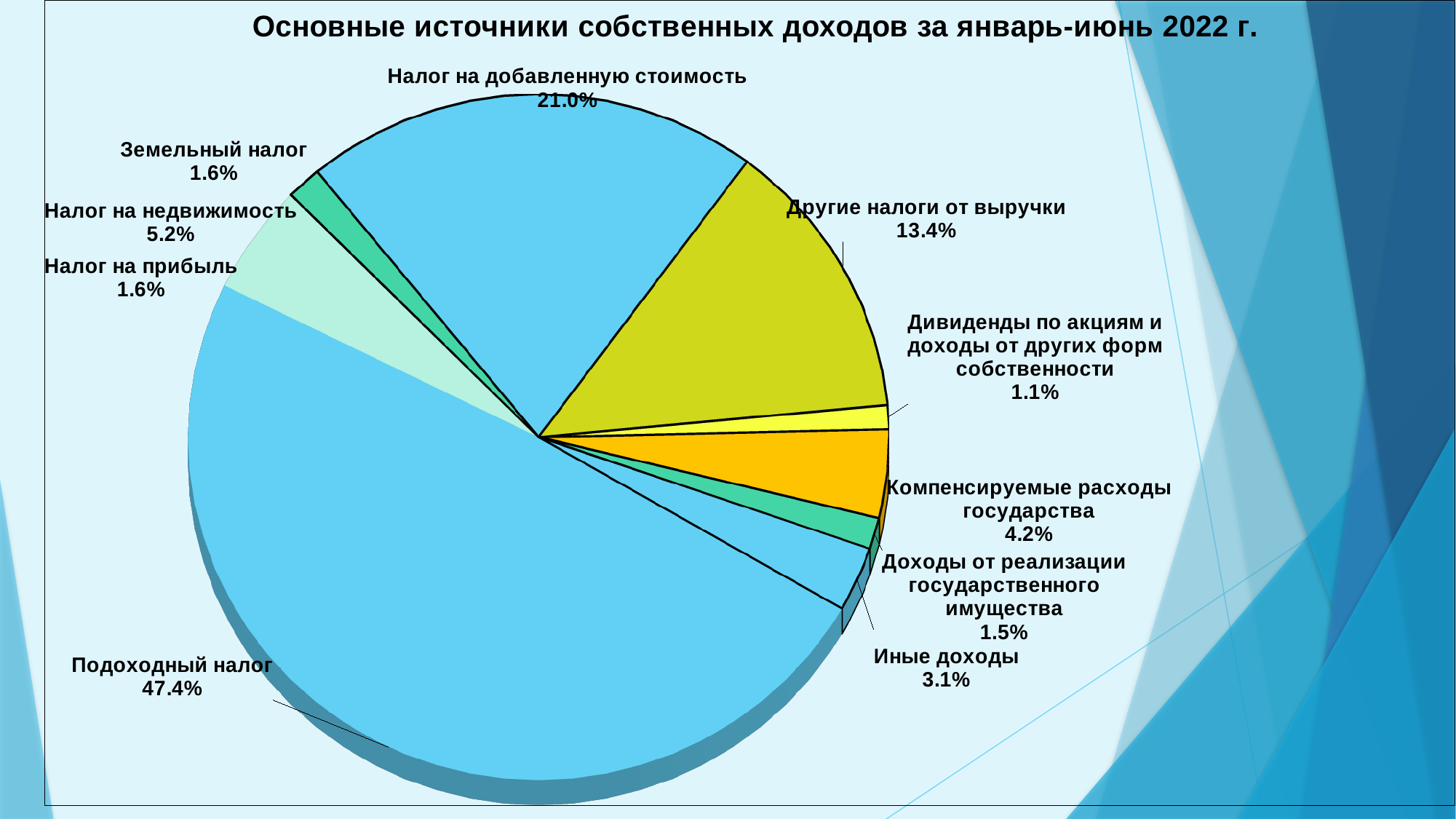
How many categories are shown in the pie chart? 10 What is the value shown for Налог на добавленную стоимость? 21.0% Which category has the smallest share of the pie? Дивиденды по акциям и доходы от других форм собственности Which is larger: Налог на недвижимость or Компенсируемые расходы государства? Налог на недвижимость What is the value shown for Компенсируемые расходы государства? 4.2% What is the difference between the shares of Подоходный налог and Налог на добавленную стоимость? 26.4% What type of chart is shown on the slide? Pie chart What is the title of the chart? Основные источники собственных доходов за январь-июнь 2022 г. What is the value shown for Другие налоги от выручки? 13.4% What is the value shown for Иные доходы? 3.1% Which category has the largest share of the pie? Подоходный налог What share of the pie does Подоходный налог account for? 47.4%